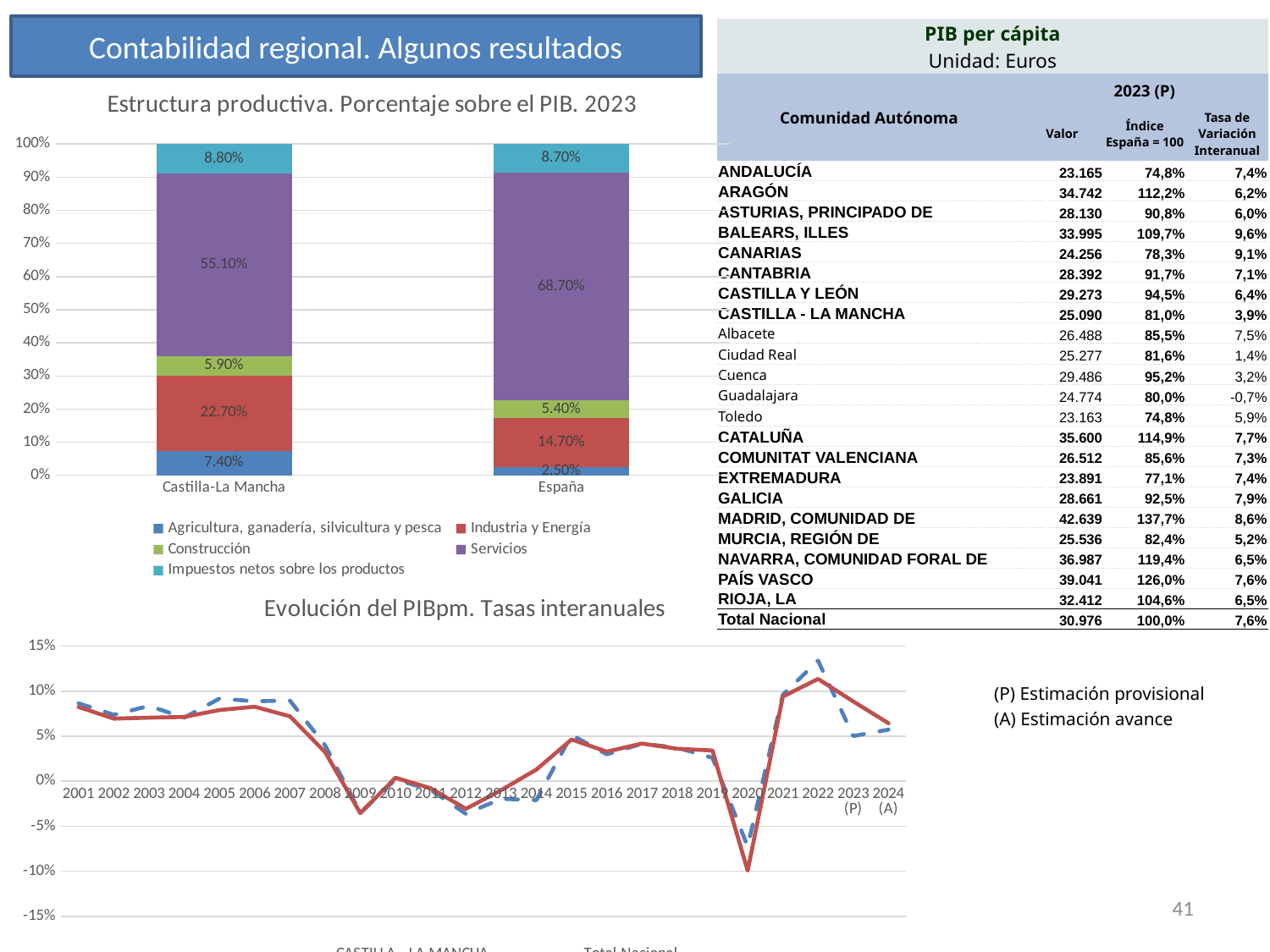
In the 'Estructura productiva. Porcentaje sobre el PIB. 2023' chart, what is the value for Industria y Energía in España? 14.70% In the 'Estructura productiva. Porcentaje sobre el PIB. 2023' chart, which sector has the largest share in España? Servicios How many years are shown on the x axis of the 'Evolución del PIBpm. Tasas interanuales' chart? 24 In the 'Estructura productiva. Porcentaje sobre el PIB. 2023' chart, what is the value for Agricultura, ganadería, silvicultura y pesca in Castilla-La Mancha? 7.40% What kind of chart is 'Estructura productiva. Porcentaje sobre el PIB. 2023'? Stacked bar chart In the 'Estructura productiva. Porcentaje sobre el PIB. 2023' chart, what is the difference between the Industria y Energía share in Castilla-La Mancha and in España? 8.00% In the 'Estructura productiva. Porcentaje sobre el PIB. 2023' chart, which sector has the smallest share in España? Agricultura, ganadería, silvicultura y pesca How many series does the legend of the 'Estructura productiva. Porcentaje sobre el PIB. 2023' chart list? 5 In the 'Evolución del PIBpm. Tasas interanuales' chart, is the value for Castilla-La Mancha in 2020 greater or less than -5%? less In the 'Estructura productiva. Porcentaje sobre el PIB. 2023' chart, what is the value for Servicios in Castilla-La Mancha? 55.10% In the 'Estructura productiva. Porcentaje sobre el PIB. 2023' chart, which has a larger Servicios share, Castilla-La Mancha or España? España What kind of chart is 'Evolución del PIBpm. Tasas interanuales'? Line chart